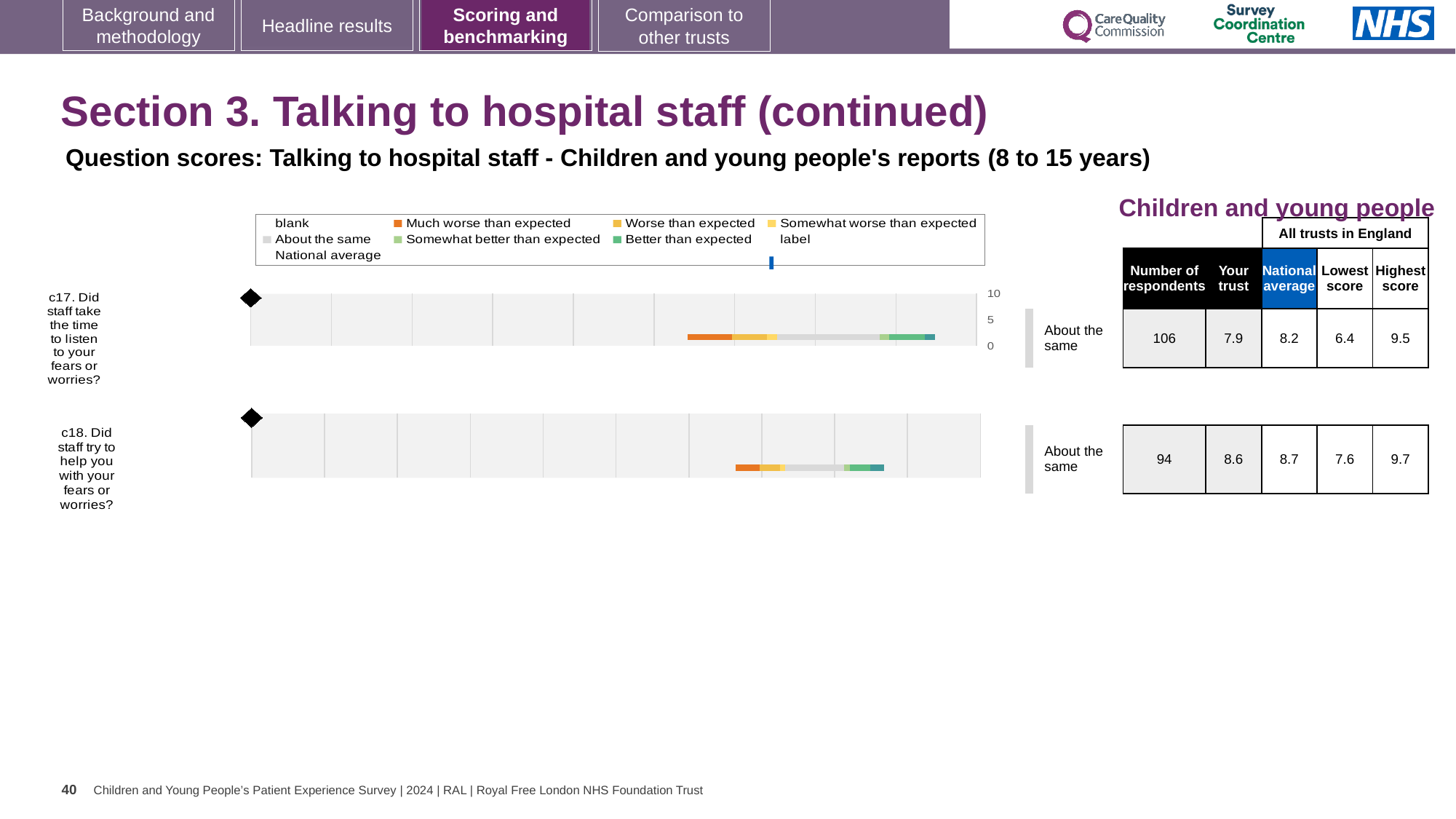
What is the 'Your trust' score for c17 (Did staff take the time to listen to your fears or worries?)? 7.9 What is the lowest score across all trusts in England for c18? 7.6 Which question has the higher 'Your trust' score, c17 or c18? c18 What colour represents 'Much worse than expected' in the legend? orange What benchmark category is shown for c17? About the same What is the national average score for c18 (Did staff try to help you with your fears or worries?)? 8.7 How many respondents answered c17? 106 By how much does the national average exceed the trust's score for c18? 0.1 What kind of chart is used to show the question scores for c17 and c18? bar chart How many survey questions are plotted on the chart? 2 What is the difference between the highest score and the lowest score for c17? 3.1 What is the highest score across all trusts in England for c18? 9.7